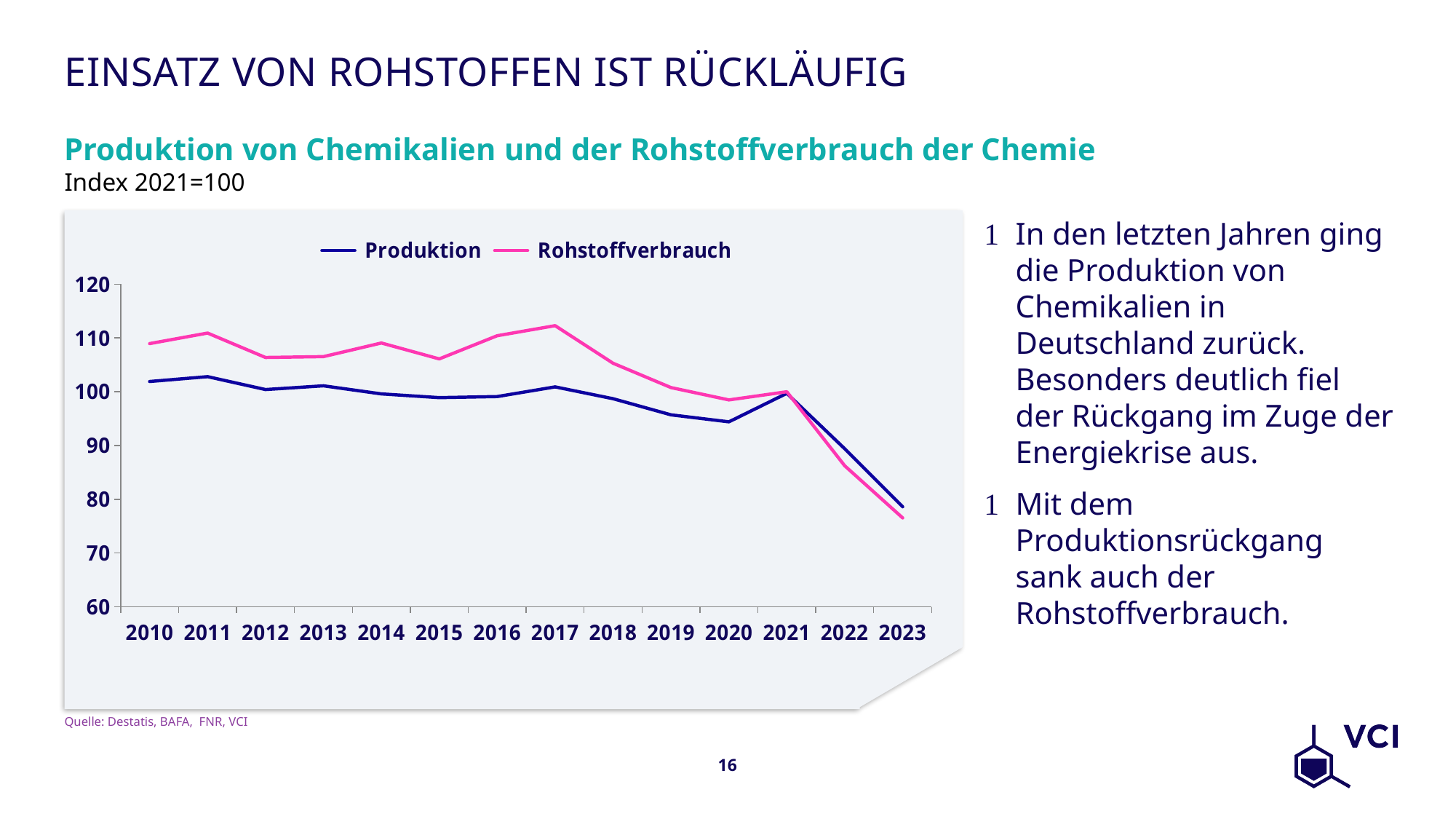
Do the values of Rohstoffverbrauch rise or fall from 2021 to 2023? Fall How many series does the chart legend list? 2 In 2017, which series has the higher value, Produktion or Rohstoffverbrauch? Rohstoffverbrauch How many years are shown on the x axis of the chart? 14 What kind of chart is shown on the slide? Line chart Is the value for Rohstoffverbrauch in 2017 greater or less than 110? greater Is the value for Produktion in 2023 greater or less than 80? less Which colour is used for the Rohstoffverbrauch line in the chart? Pink In which year is the Produktion series at its lowest? 2023 Is the value for Rohstoffverbrauch in 2022 greater or less than 90? less